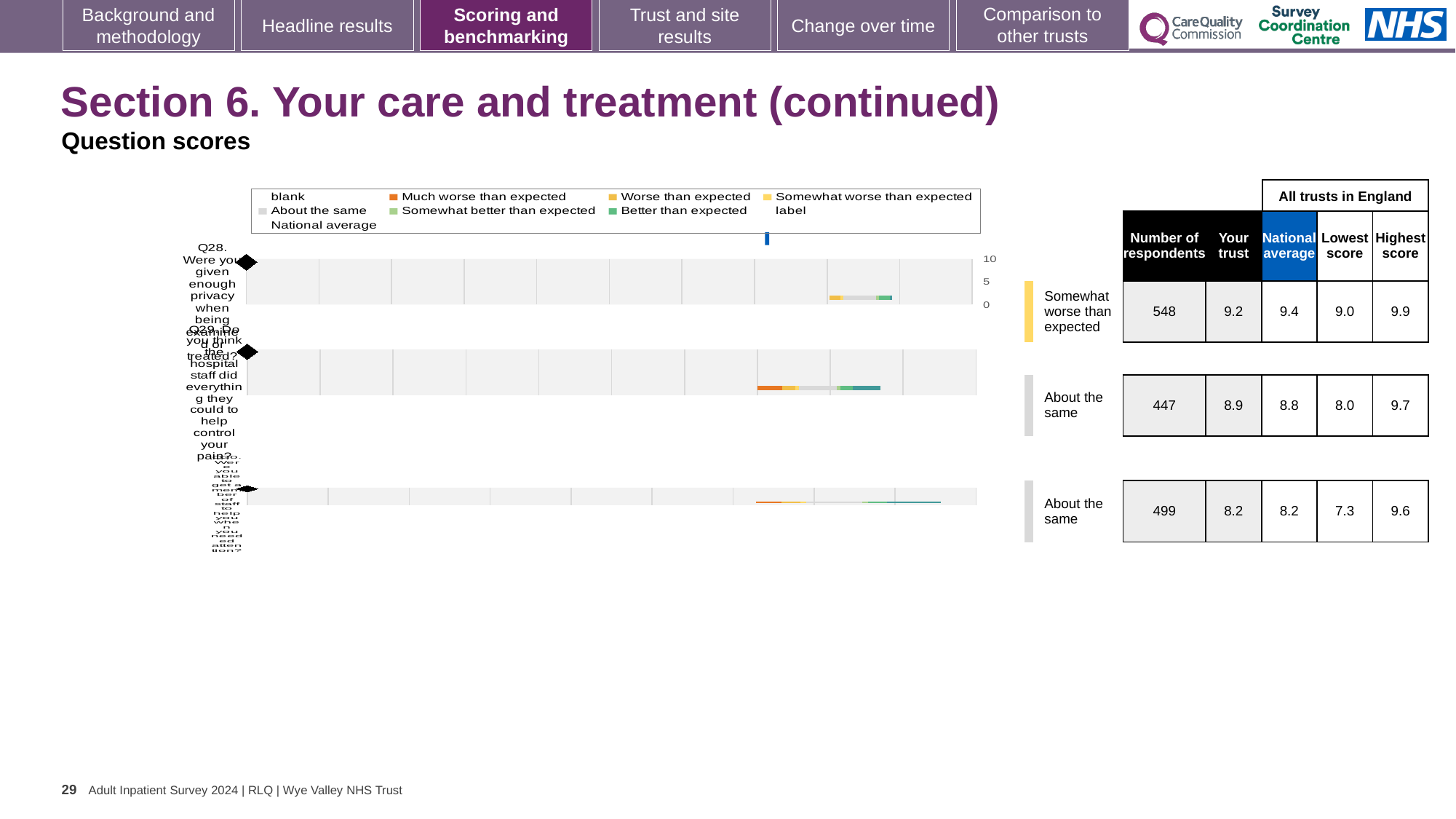
What kind of chart is shown on the slide? Bar chart Which benchmark category is Q28 placed in? Somewhat worse than expected How many respondents answered Q29 (Do you think the hospital staff did everything they could to help control your pain?)? 447 What is the highest score among all trusts in England for Q30? 9.6 What is the national average score for Q28? 9.4 Which question has the highest 'Your trust' score? Q28 How many survey questions are plotted in the chart? 3 What is the 'Your trust' score for Q28 (Were you given enough privacy when being examined or treated?)? 9.2 What is the lowest score among all trusts in England for Q29? 8.0 For Q28, which is larger: the 'Your trust' score or the national average? National average What is the difference between the highest score and the lowest score for Q29? 1.7 How many respondents answered Q30? 499